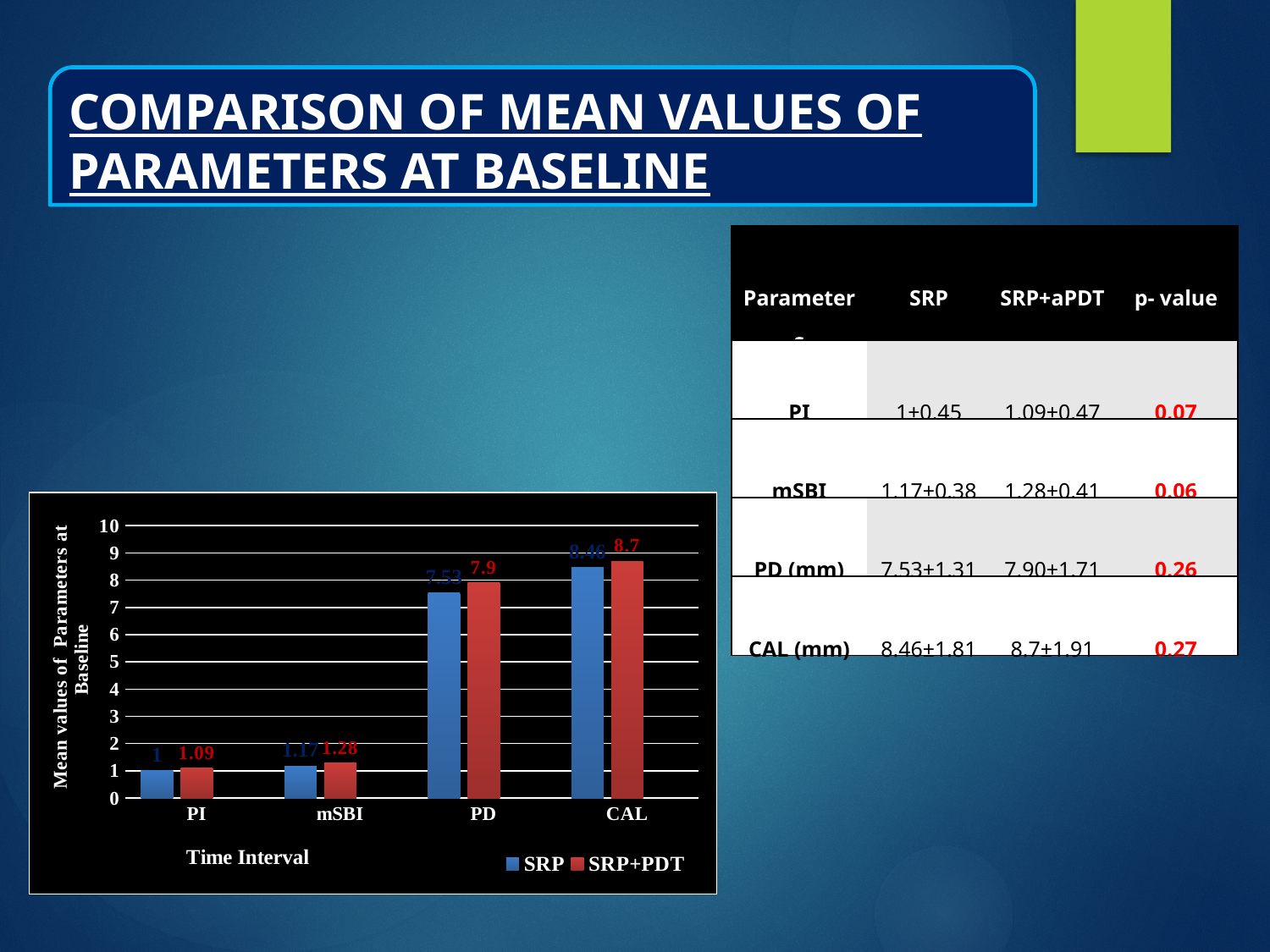
What is the SRP+PDT value for CAL in the chart? 8.7 What is the difference between the SRP+PDT and SRP values for PD in the chart? 0.37 What is the SRP+PDT value for mSBI in the chart? 1.28 What type of chart is shown on the slide? bar chart How many categories are shown on the x axis of the chart? 4 What is the title of the x axis of the chart? Time Interval How many series does the chart legend list? 2 Which category has the lowest SRP+PDT value in the chart? PI Which is larger for CAL in the chart, the SRP value or the SRP+PDT value? SRP+PDT What is the SRP value for PD in the chart? 7.53 Do the SRP values rise or fall from PI to CAL along the x axis of the chart? rise Which category has the highest SRP value in the chart? CAL